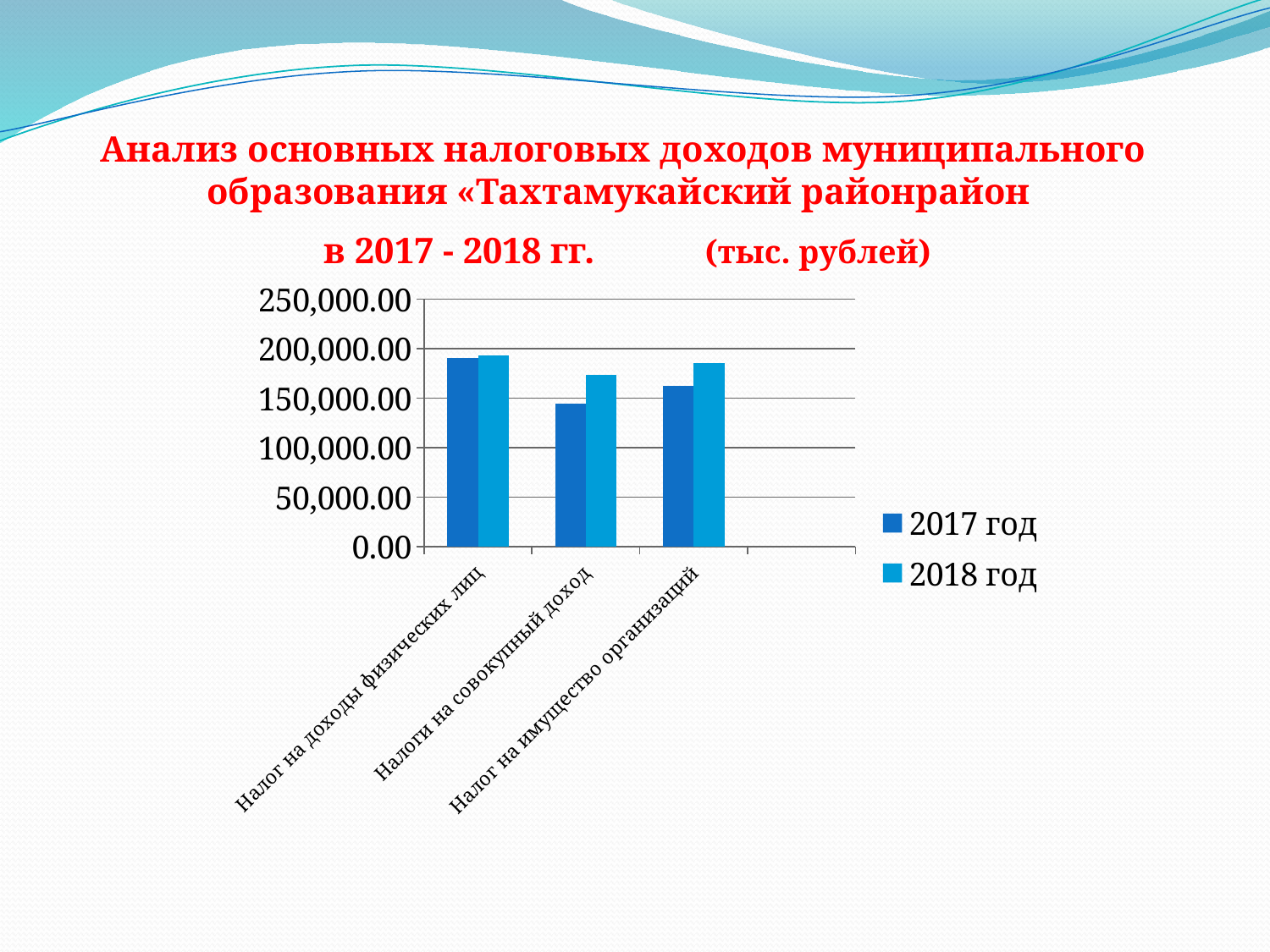
How many tax categories are shown on the x axis? 3 What are the two entries in the chart legend? 2017 год and 2018 год Is the 2017 год value for Налоги на совокупный доход greater or less than 150,000.00? less For Налог на имущество организаций, which year has the larger value, 2017 год or 2018 год? 2018 год Is the 2017 год value for Налог на доходы физических лиц greater or less than 200,000.00? less Is the 2018 год value for Налог на имущество организаций greater or less than 150,000.00? greater Which category has the highest value for 2017 год? Налог на доходы физических лиц Which category has the lowest value for 2017 год? Налоги на совокупный доход For Налоги на совокупный доход, which year has the larger value, 2017 год or 2018 год? 2018 год What kind of chart is shown on the slide? bar chart How many series does the legend list? 2 Which category has the lowest value for 2018 год? Налоги на совокупный доход